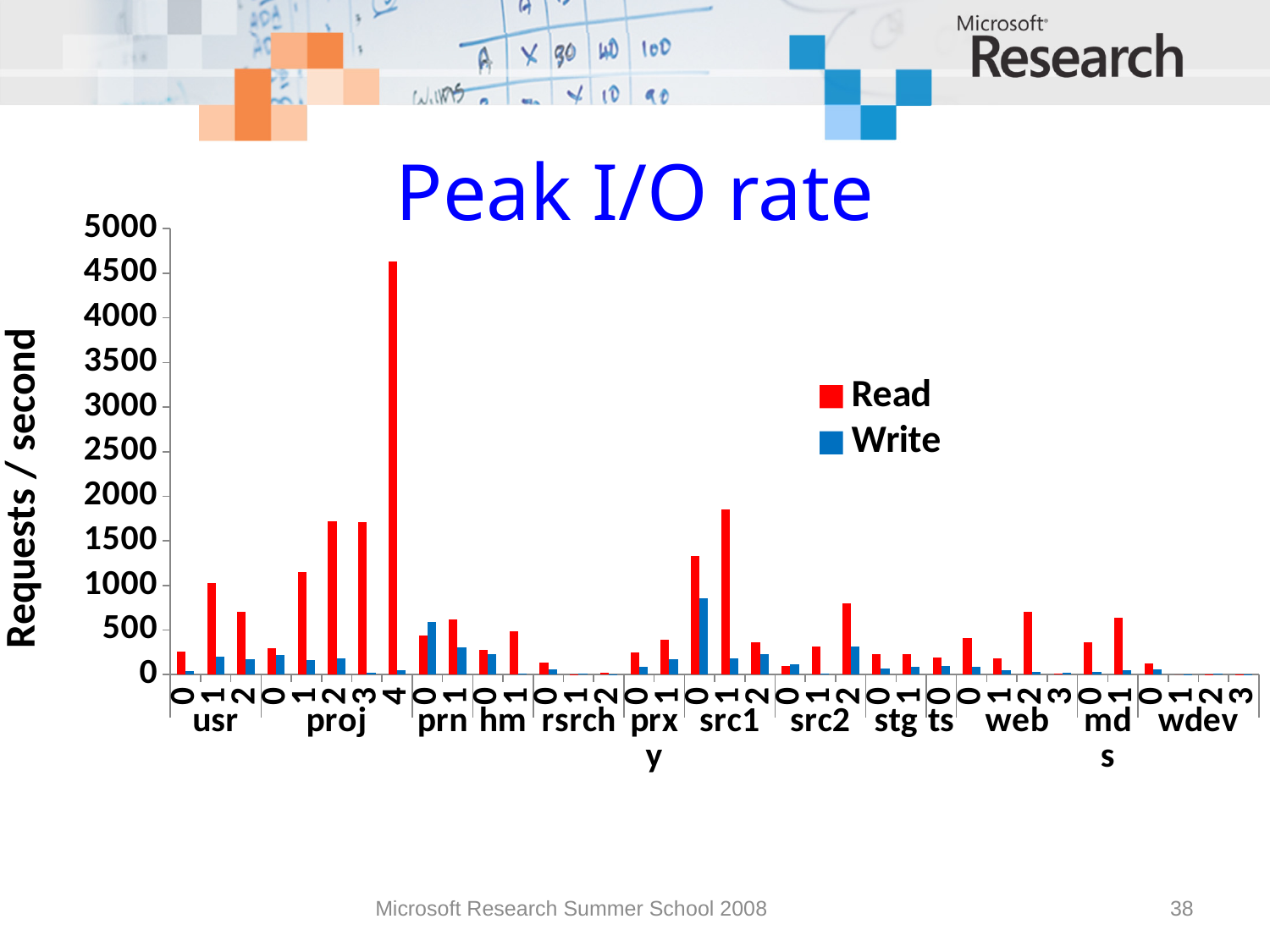
Which volume has the highest Read peak I/O rate? proj 4 Is the Read value for proj 2 greater or less than 1500? greater For prn 0, which is larger, the Read value or the Write value? Write Is the Read value for src1 1 greater or less than 1500? greater What kind of chart is shown on the slide? bar chart Which series are listed in the legend? Read and Write Is the Read value for proj 4 greater or less than 4000? greater What is the label of the vertical axis? Requests / second Which has the larger Read value, src1 1 or src2 2? src1 1 How many series does the legend list? 2